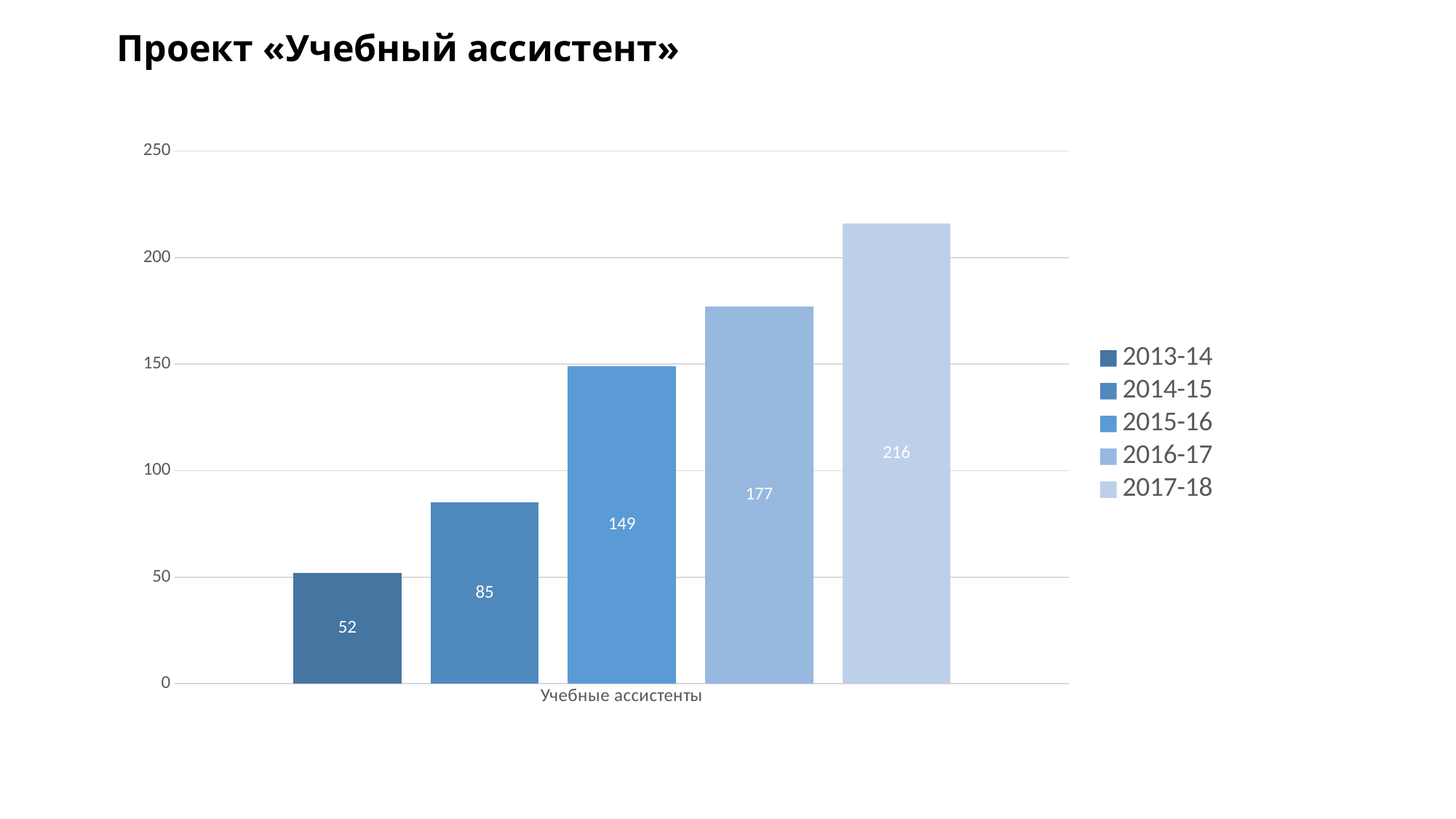
Which is larger, the value for 2014-15 or the value for 2016-17? 2016-17 What kind of chart is shown on the slide? bar chart How many series does the legend list? 5 What is the difference between the values for 2017-18 and 2016-17? 39 What is the difference between the values for 2015-16 and 2014-15? 64 What is the value for 2017-18? 216 Is the value for 2016-17 greater or less than 150? greater What is the value for 2015-16? 149 Which series has the highest value? 2017-18 Which series has the lowest value? 2013-14 What is the value for 2013-14? 52 What is the category label on the x axis? Учебные ассистенты